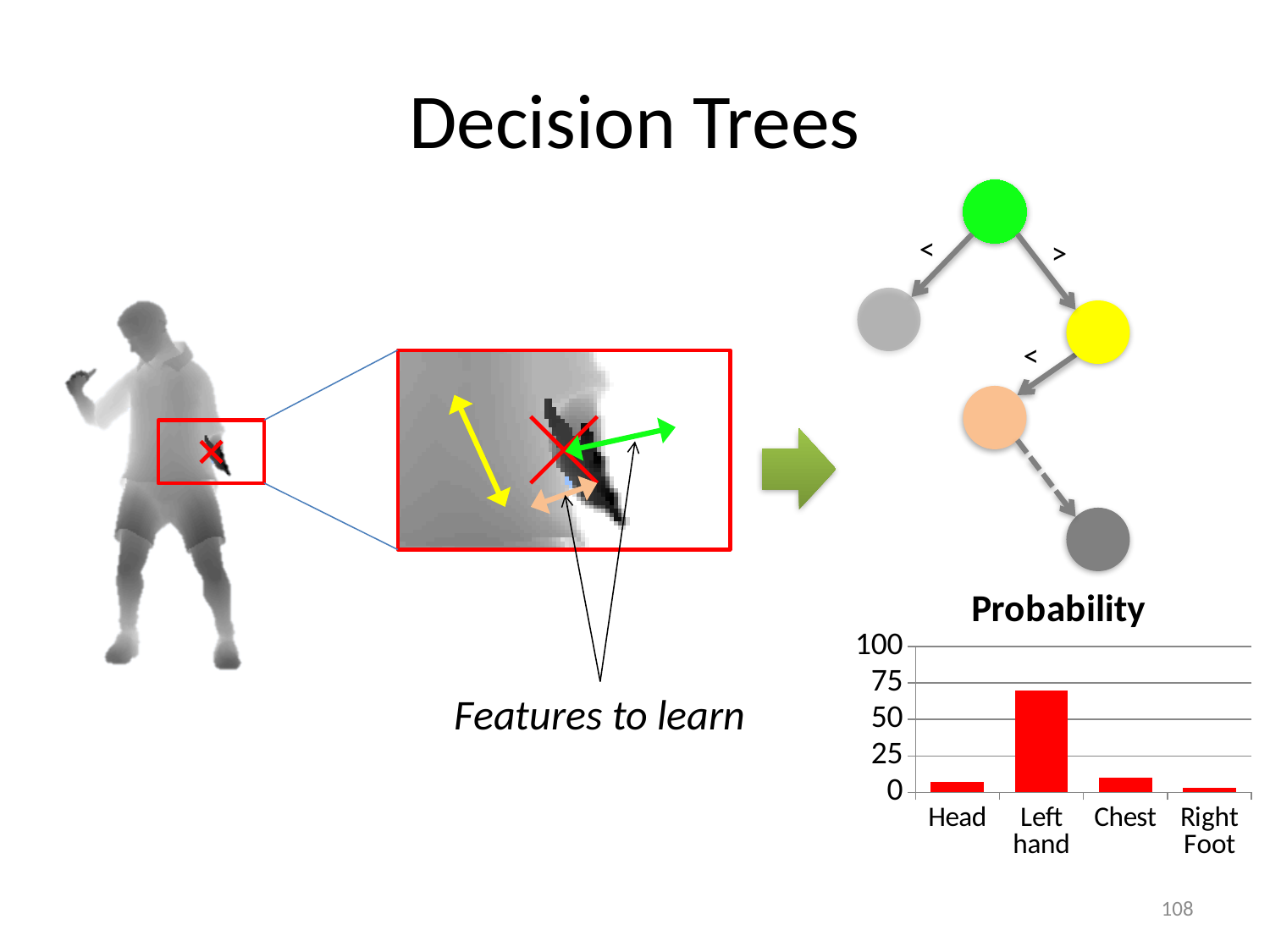
Which category has the highest bar in the Probability chart? Left hand How many categories are shown on the x axis of the Probability chart? 4 What is the highest value shown on the y axis of the Probability chart? 100 What colour are the bars in the Probability chart? red What kind of chart is shown under the title "Probability"? bar chart What is the title of the chart on the slide? Probability Is the value for Left hand greater or less than 50? greater Is the value for Head greater or less than 25? less Is the value for Left hand greater or less than 75? less Which is larger in the Probability chart, the value for Left hand or the value for Head? Left hand Which is larger in the Probability chart, the value for Chest or the value for Right Foot? Chest